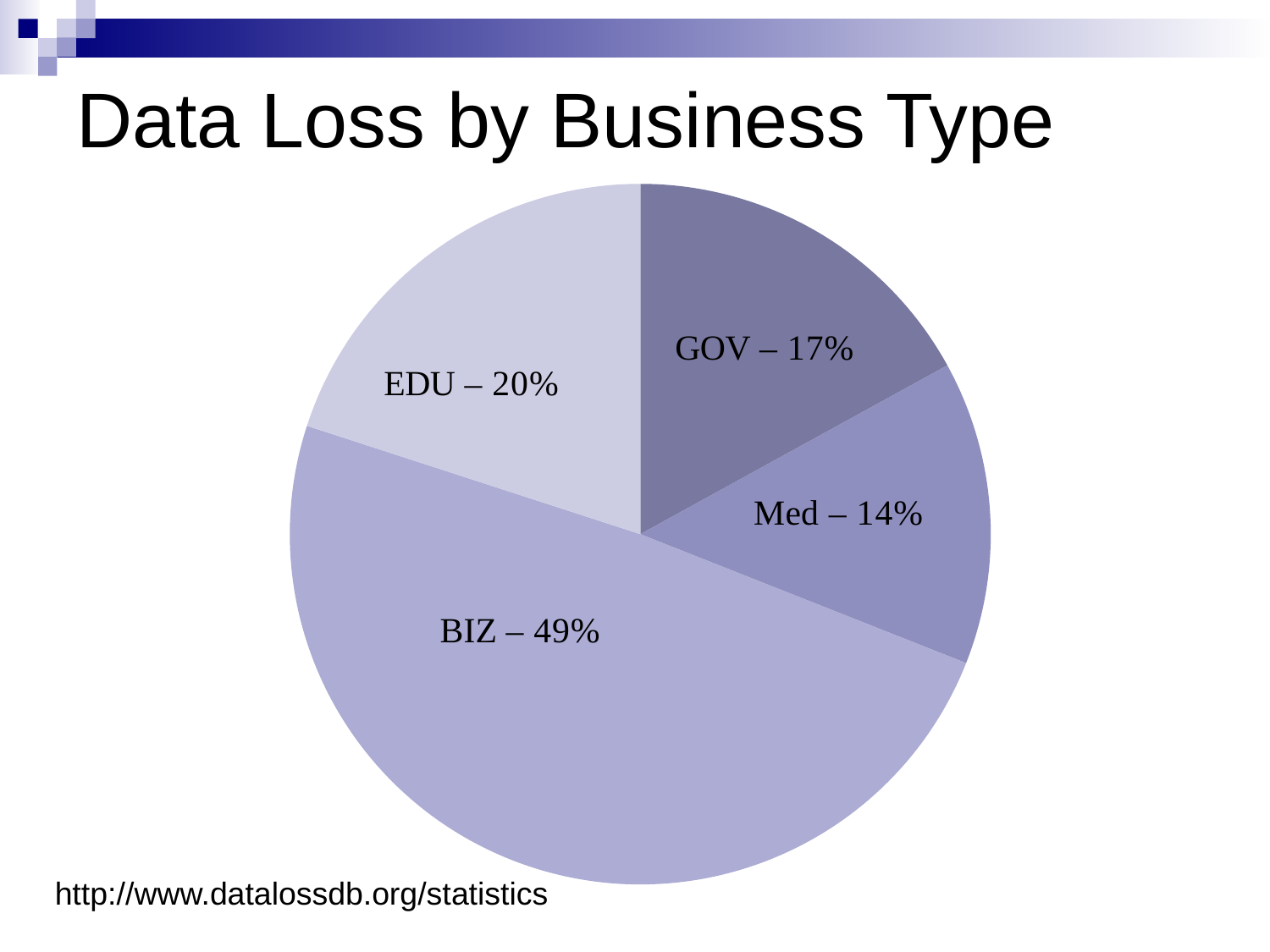
What share of data loss is attributed to BIZ? 49% How many slices does the pie chart have? 4 What share of data loss is attributed to EDU? 20% What share of data loss is attributed to Med? 14% What share of data loss is attributed to GOV? 17% What is the difference in percentage points between the GOV and Med shares? 3 What kind of chart is shown on the slide? pie chart What is the title of the chart on the slide? Data Loss by Business Type Which business type has the smallest share of data loss? Med What is the difference in percentage points between the BIZ and EDU shares? 29 Which business type has the largest share of data loss? BIZ Which has a larger share of data loss, EDU or GOV? EDU